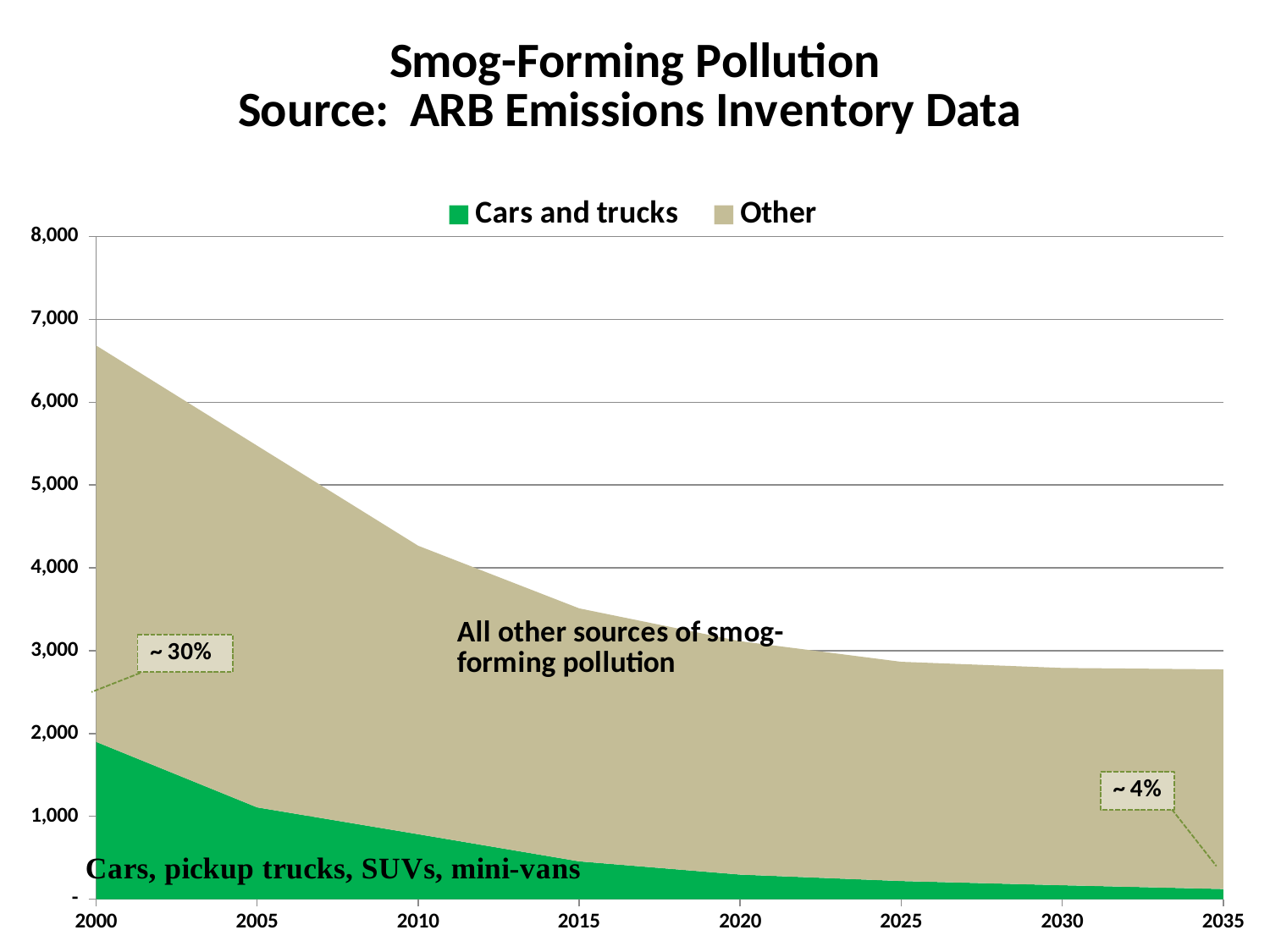
Is the value for Cars and trucks in 2000 greater or less than 1,000? greater How many series does the legend list? 2 What are the two series named in the legend? Cars and trucks; Other Which series is larger in 2020, Cars and trucks or Other? Other Does total smog-forming pollution rise or fall from 2000 to 2035? Fall Is the value for Cars and trucks in 2000 greater or less than 2,000? less How many year labels are shown on the x axis? 8 What kind of chart is shown on the slide? Stacked area chart Is the value for Cars and trucks in 2035 greater or less than 1,000? less What percentage label is shown in the callout near 2035? ~ 4%